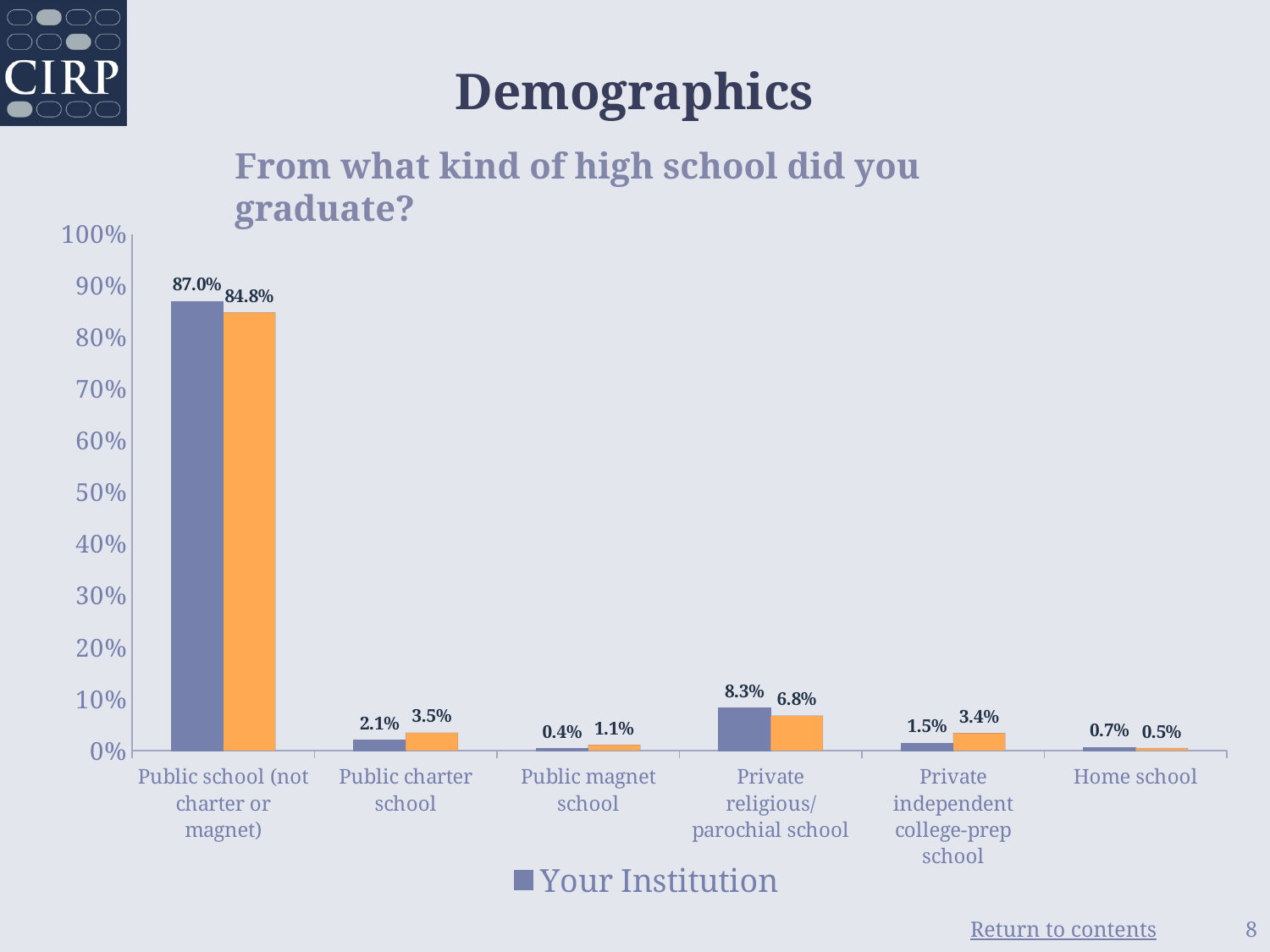
What kind of chart is shown on the slide? Bar chart What is the difference between the Your Institution values for Public school (not charter or magnet) and Private religious/parochial school? 78.7 percentage points How many high school categories are shown on the x axis? 6 Which category has the lowest Your Institution value? Public magnet school For Your Institution, which is larger: Public charter school or Private independent college-prep school? Public charter school What is the question shown as the chart's title? From what kind of high school did you graduate? What is the Your Institution value for Home school? 0.7% Which category has the highest Your Institution value? Public school (not charter or magnet) Is the Your Institution value for Public school (not charter or magnet) greater or less than 80%? greater What is the Your Institution value for Public school (not charter or magnet)? 87.0% What is the Your Institution value for Public magnet school? 0.4% What is the Your Institution value for Private religious/parochial school? 8.3%